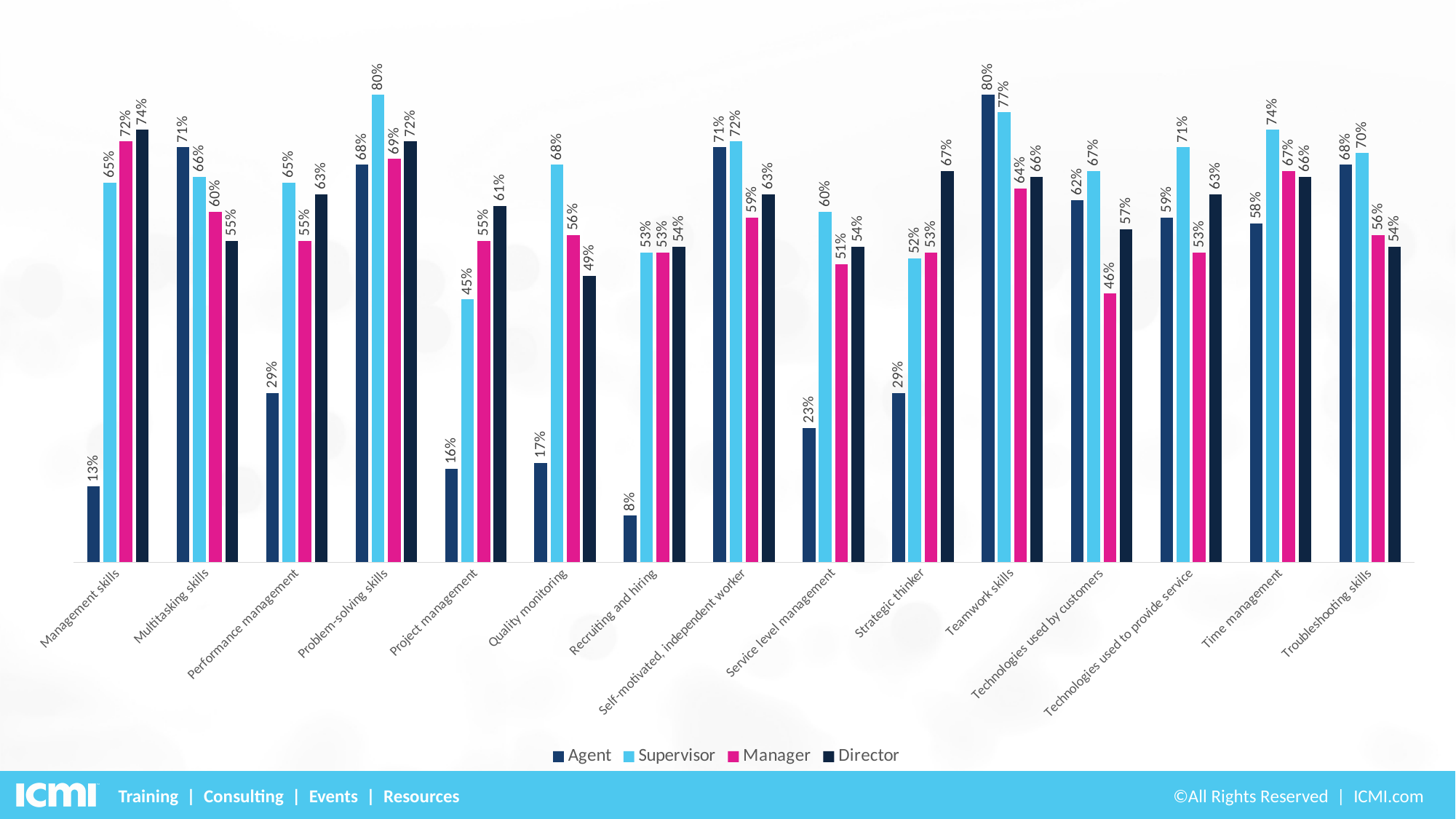
Which category has the highest Agent value? Teamwork skills What is the Agent value for Management skills? 13% Which is larger for Project management, the Manager value or the Director value? Director How many categories are shown on the x axis? 15 What is the Supervisor value for Problem-solving skills? 80% What is the Manager value for Technologies used by customers? 46% What is the Director value for Strategic thinker? 67% Which series is shown in pink in the legend? Manager Which category has the lowest Agent value? Recruiting and hiring What is the difference between the Supervisor and Agent values for Quality monitoring? 51% What kind of chart is shown on the slide? Bar chart How many series does the legend list? 4